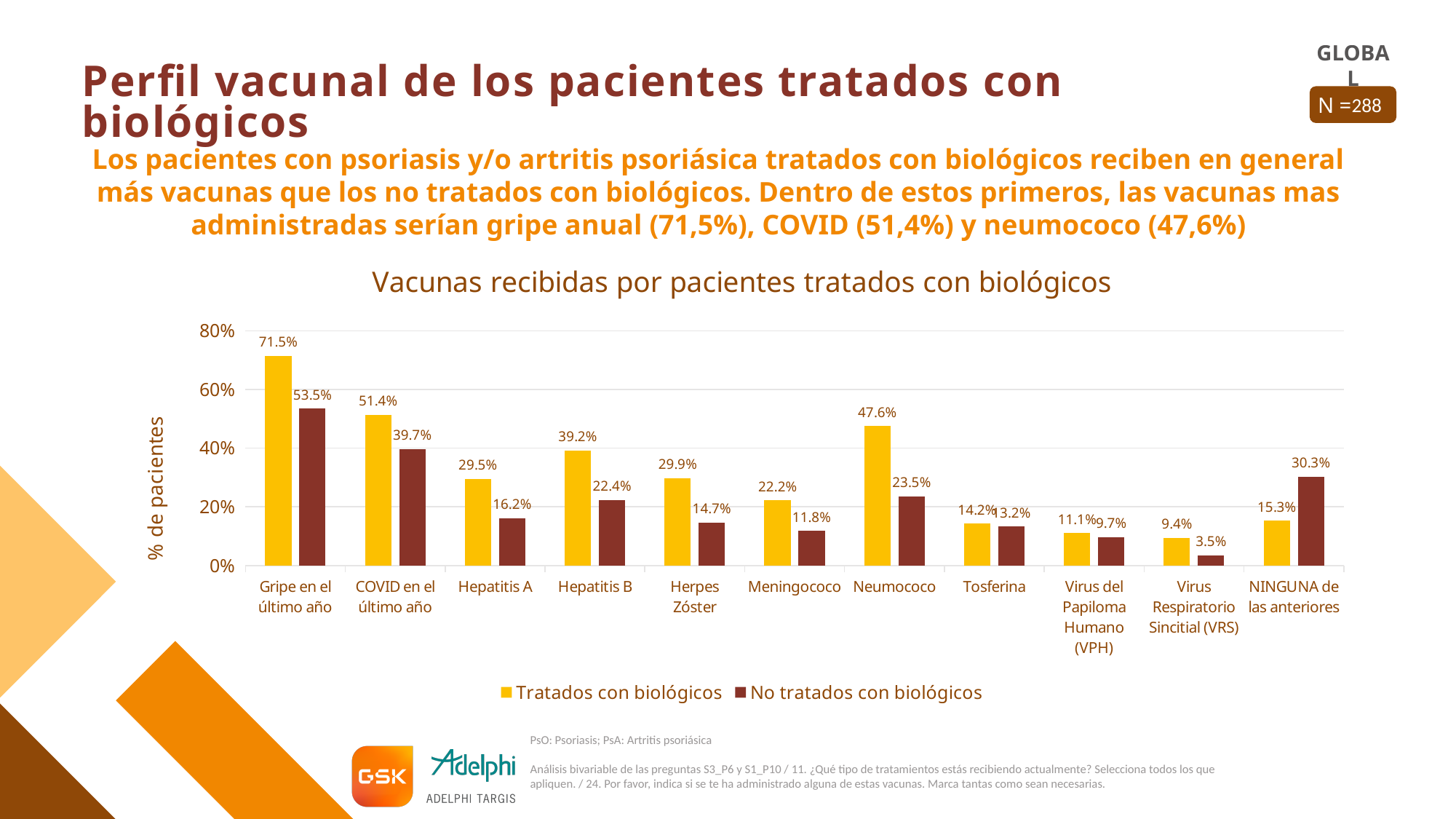
For NINGUNA de las anteriores, which series has the larger value? No tratados con biológicos What is the value for No tratados con biológicos for Neumococo? 23.5% Which category has the lowest value for the No tratados con biológicos series? Virus Respiratorio Sincitial (VRS) What is the value for Tratados con biológicos for Hepatitis B? 39.2% Which category has the highest value for the Tratados con biológicos series? Gripe en el último año What is the difference between the Tratados con biológicos and No tratados con biológicos values for COVID en el último año? 11.7% What kind of chart is shown on the slide? Bar chart What percentage of patients treated with biologics (Tratados con biológicos) received the Gripe en el último año vaccine? 71.5% How many vaccine categories are shown on the x axis? 11 How many series does the legend list? 2 Is the value for Tratados con biológicos for Neumococo greater or less than 40%? greater What is the title of the chart? Vacunas recibidas por pacientes tratados con biológicos